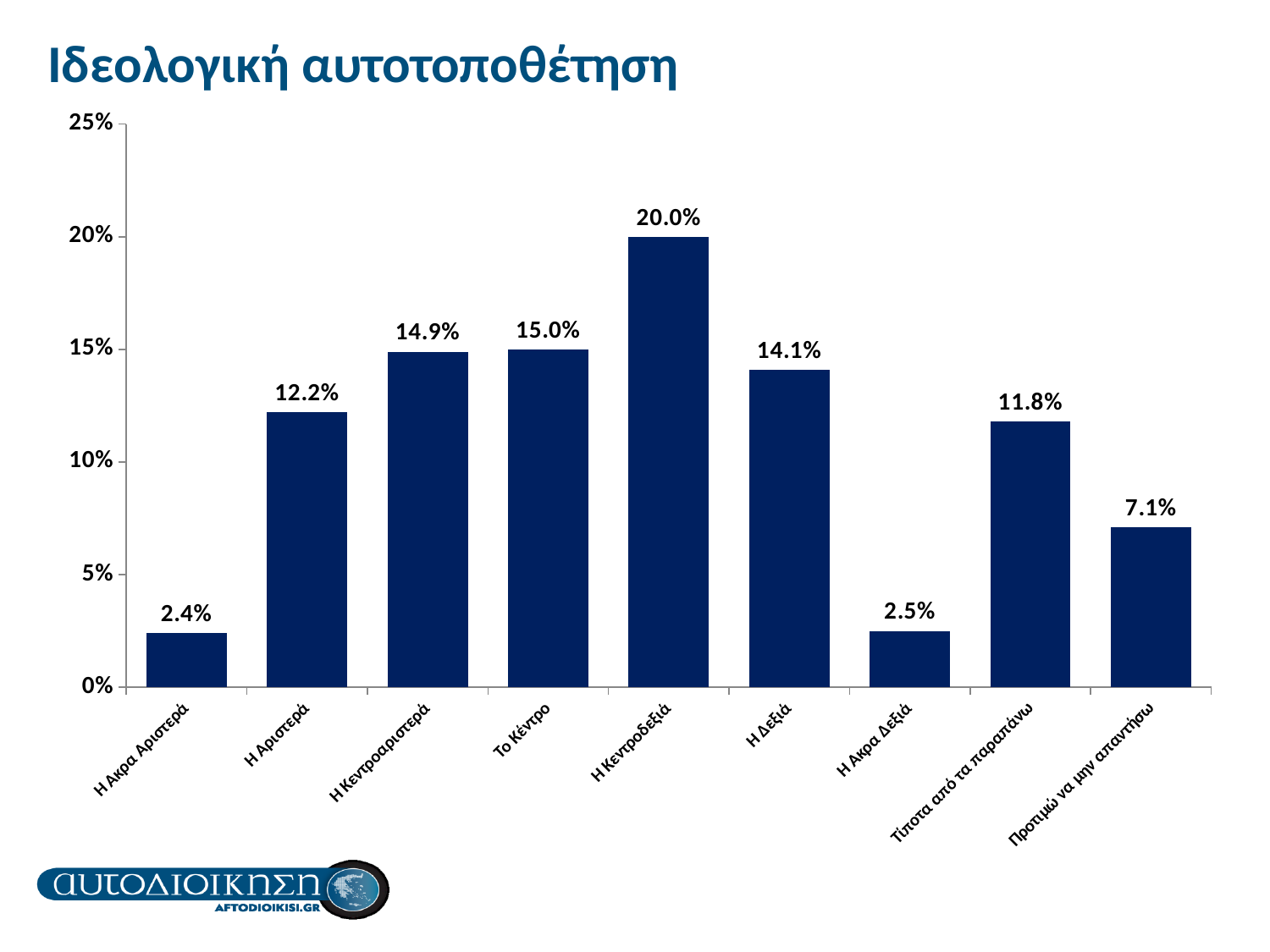
Is the value for Η Δεξιά greater or less than 10%? greater What is the difference between the values for Τίποτα από τα παραπάνω and Προτιμώ να μην απαντήσω? 4.7% What is the title of the slide? Ιδεολογική αυτοτοποθέτηση Which category has the lowest value? Η Άκρα Αριστερά What is the value for Η Αριστερά? 12.2% What is the difference between the values for Η Κεντροδεξιά and Η Δεξιά? 5.9% How many categories are shown on the x axis? 9 Which category has the highest value? Η Κεντροδεξιά What kind of chart is shown on the slide? bar chart What is the value for Η Κεντροδεξιά? 20.0% Which is larger, the value for Η Κεντροαριστερά or the value for Η Δεξιά? Η Κεντροαριστερά What is the value for Προτιμώ να μην απαντήσω? 7.1%